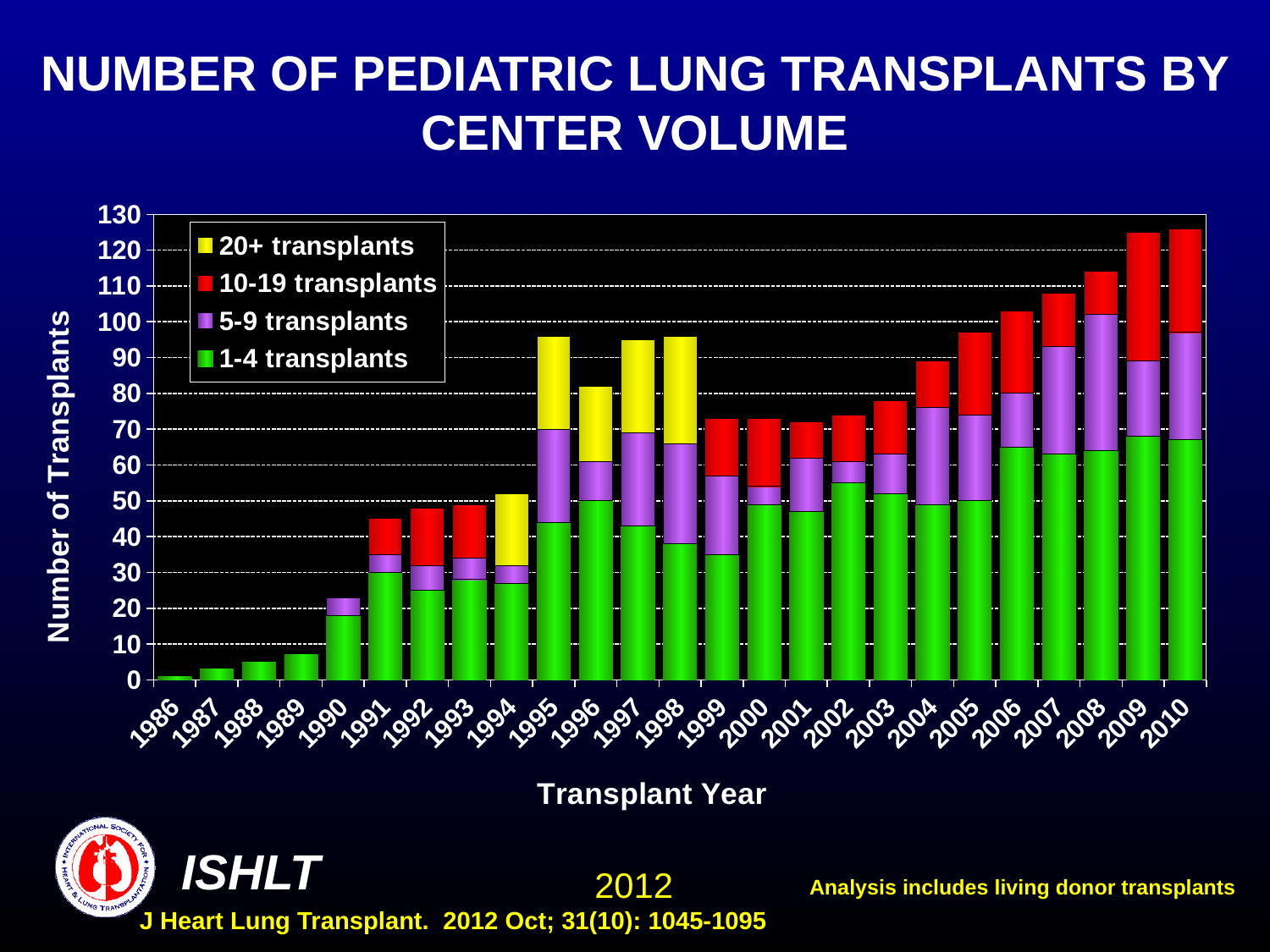
Do the total numbers of transplants generally rise or fall from 2001 to 2010? rise Is the total number of transplants in 2006 greater or less than 100? greater Which transplant year has the lowest total number of transplants? 1986 Which year has a larger total number of transplants, 1995 or 1996? 1995 How many series does the legend list? 4 Is the total number of transplants in 2010 greater or less than 120? greater What colour represents the '20+ transplants' series in the legend? Yellow What kind of chart is shown on the slide? Stacked bar chart Is the total number of transplants in 1990 greater or less than 30? less How many transplant years are shown along the x axis? 25 Which year has a larger total number of transplants, 2000 or 2006? 2006